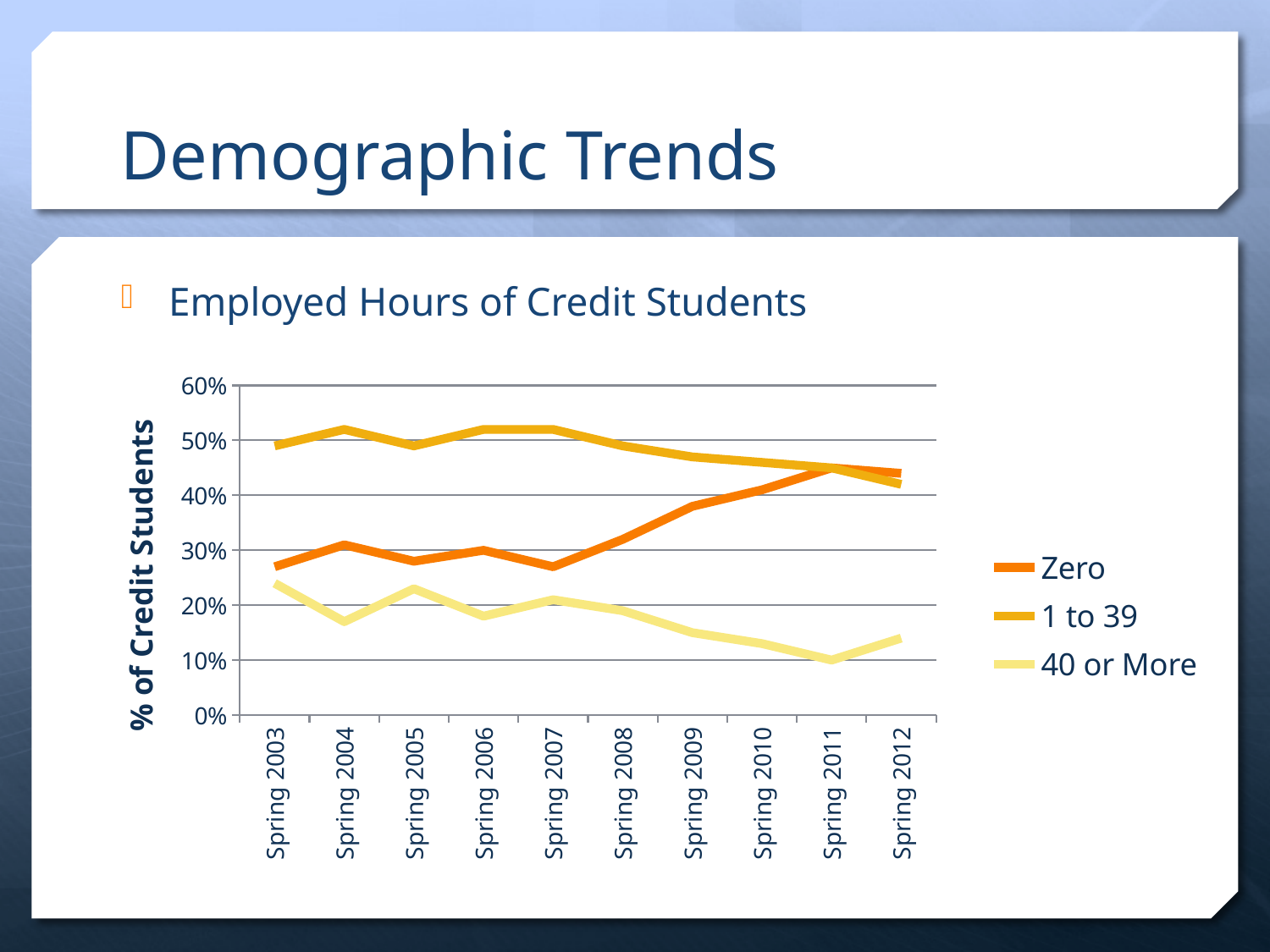
Which series has the lowest value in Spring 2010? 40 or More In Spring 2003, which is larger: the value for Zero or the value for 40 or More? Zero Which series has the highest value in Spring 2007? 1 to 39 Does the Zero series generally rise or fall from Spring 2003 to Spring 2012? Rise Is the value for Zero in Spring 2011 greater or less than 40%? greater What kind of chart is shown on the slide? Line chart How many time points are plotted along the x axis? 10 How many series does the legend list? 3 What is the title of the vertical axis? % of Credit Students Which series is shown in the lightest yellow colour in the legend? 40 or More Is the value for 1 to 39 in Spring 2012 greater or less than 50%? less Is the value for 40 or More in Spring 2010 greater or less than 20%? less